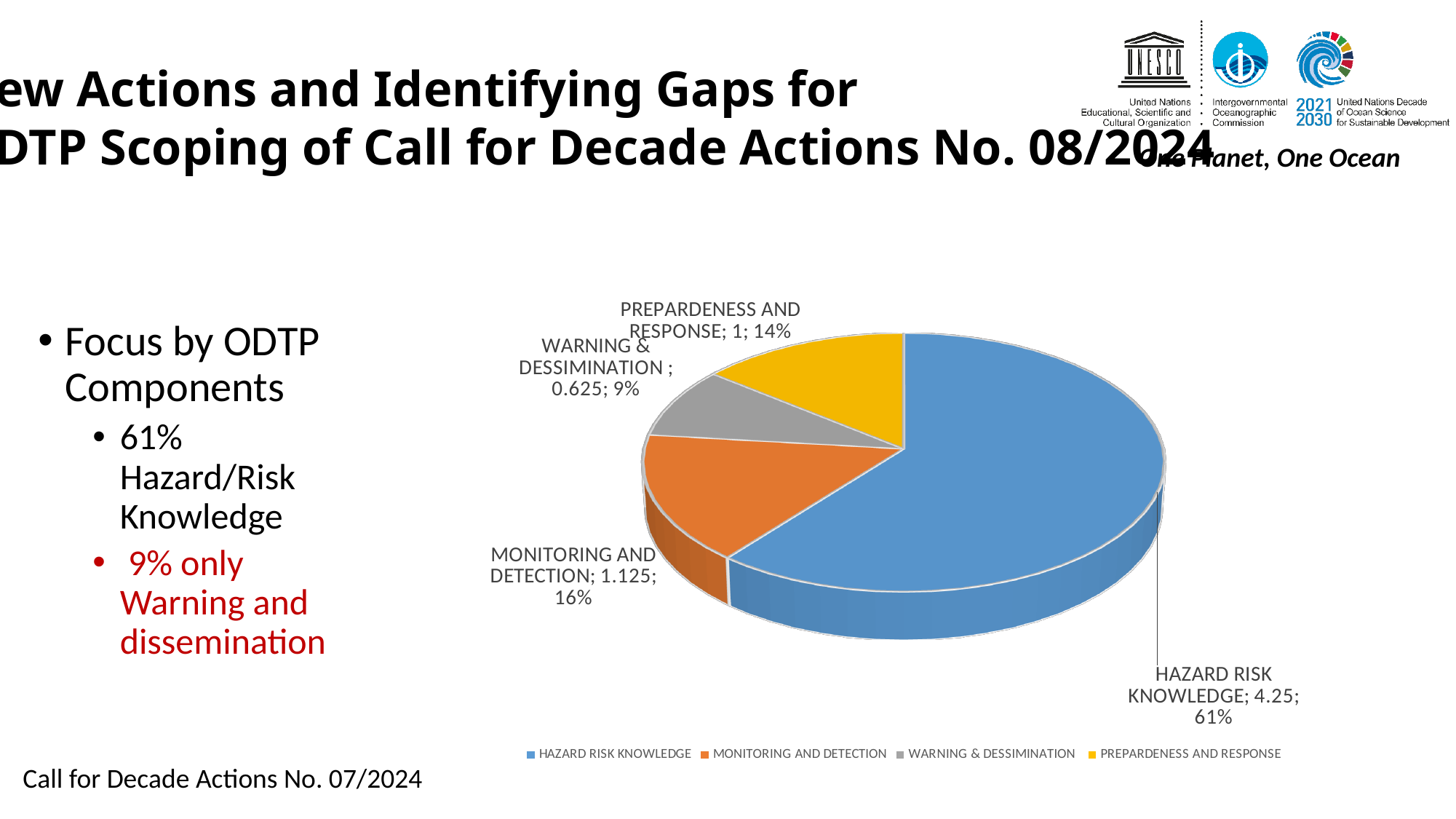
What colour is the HAZARD RISK KNOWLEDGE slice? blue Which is larger, the value for PREPARDENESS AND RESPONSE or the value for WARNING & DESSIMINATION? PREPARDENESS AND RESPONSE What kind of chart is shown on the slide? pie chart How many slices does the pie chart have? 4 How many entries does the legend list? 4 What is the value for HAZARD RISK KNOWLEDGE? 4.25 What is the value for WARNING & DESSIMINATION? 0.625 Which category has the smallest slice? WARNING & DESSIMINATION What percentage share does MONITORING AND DETECTION have? 16% What is the difference between the values for HAZARD RISK KNOWLEDGE and MONITORING AND DETECTION? 3.125 What percentage share does PREPARDENESS AND RESPONSE have? 14% Which category has the largest slice? HAZARD RISK KNOWLEDGE